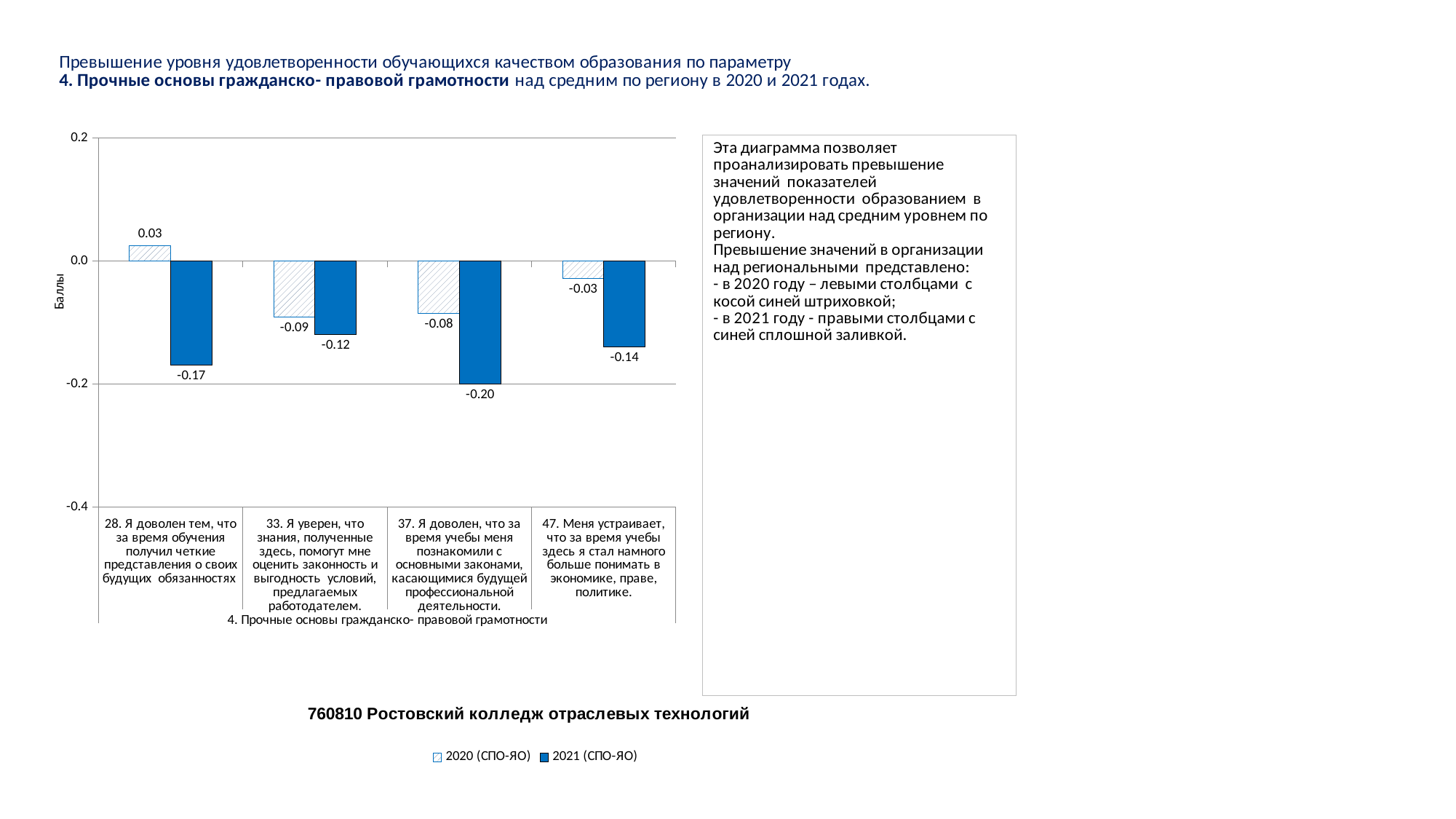
How many categories are shown on the x axis of the chart? 4 What is the value for 2021 (СПО-ЯО) for question 37 (Я доволен, что за время учебы меня познакомили с основными законами)? -0.20 Which category has the lowest value for the 2021 (СПО-ЯО) series? 37. Я доволен, что за время учебы меня познакомили с основными законами, касающимися будущей профессиональной деятельности. What kind of chart is shown on the slide? Bar chart What is the value for 2020 (СПО-ЯО) for question 33 (Я уверен, что знания, полученные здесь, помогут мне оценить законность и выгодность условий)? -0.09 Which category has the highest value for the 2020 (СПО-ЯО) series? 28. Я доволен тем, что за время обучения получил четкие представления о своих будущих обязанностях What is the difference between the 2020 and 2021 values for question 28? 0.20 What is the value for 2021 (СПО-ЯО) for question 47 (Меня устраивает, что за время учебы здесь я стал намного больше понимать в экономике, праве, политике)? -0.14 Which is larger for question 33: the 2020 (СПО-ЯО) value or the 2021 (СПО-ЯО) value? 2020 (СПО-ЯО) What is the value for 2020 (СПО-ЯО) for question 28 (Я доволен тем, что за время обучения получил четкие представления о своих будущих обязанностях)? 0.03 How many series does the legend list? 2 What is the label of the y axis of the chart? Баллы